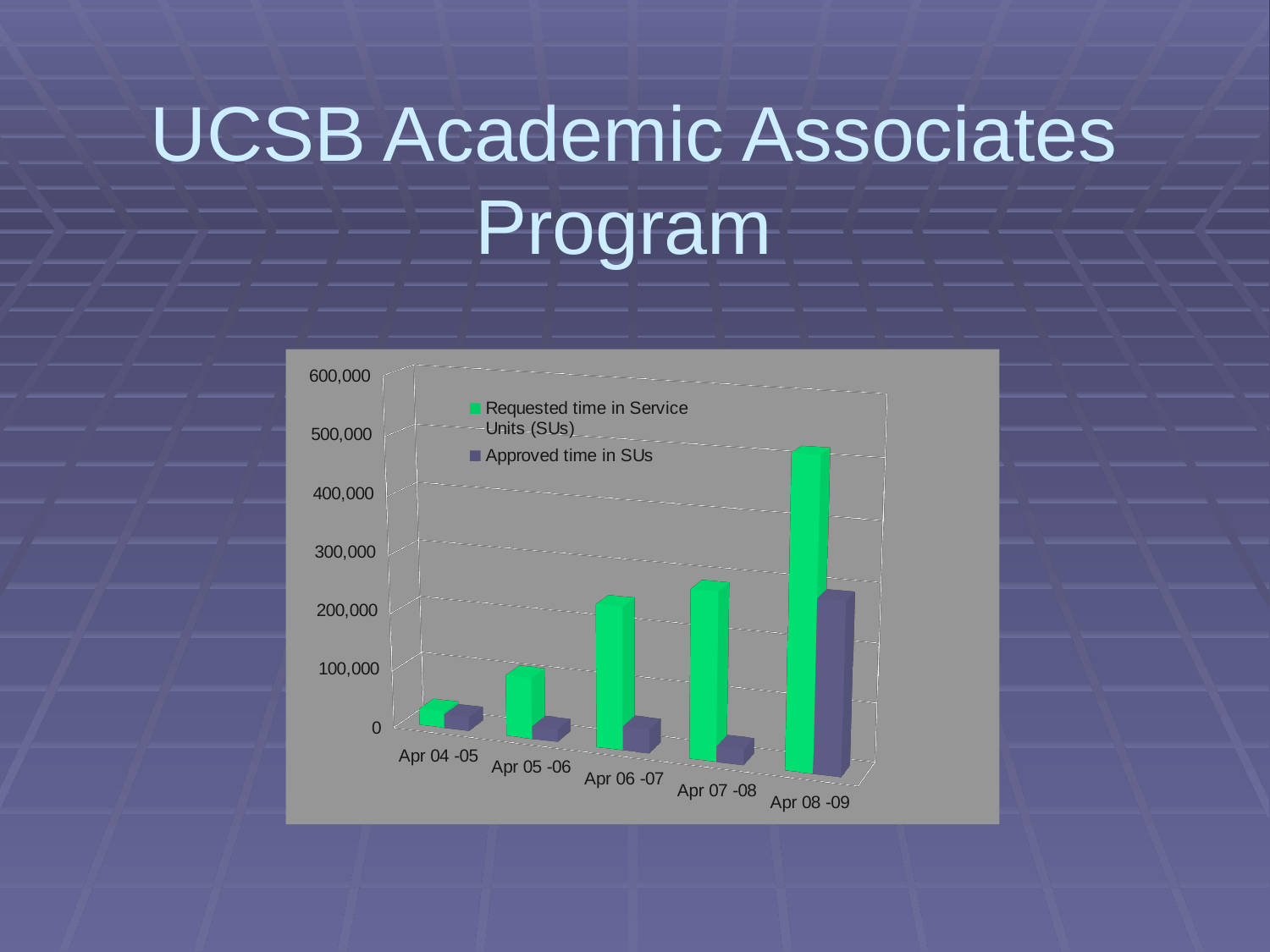
How many time periods are shown on the x axis of the chart? 5 What colour represents Requested time in Service Units (SUs) in the chart? Green Is the Requested time in Service Units (SUs) for Apr 04 -05 greater or less than 100,000? less For Apr 08 -09, which is larger: Requested time in Service Units (SUs) or Approved time in SUs? Requested time in Service Units (SUs) How many series does the chart's legend list? 2 Which period has the lowest Requested time in Service Units (SUs)? Apr 04 -05 Which period has the highest Requested time in Service Units (SUs)? Apr 08 -09 What kind of chart is shown on the slide? Bar chart Is the Requested time in Service Units (SUs) for Apr 08 -09 greater or less than 400,000? greater Which period has the highest Approved time in SUs? Apr 08 -09 Does the Requested time in Service Units (SUs) rise or fall from Apr 04 -05 to Apr 08 -09? Rise Is the Approved time in SUs for Apr 08 -09 greater or less than 100,000? greater